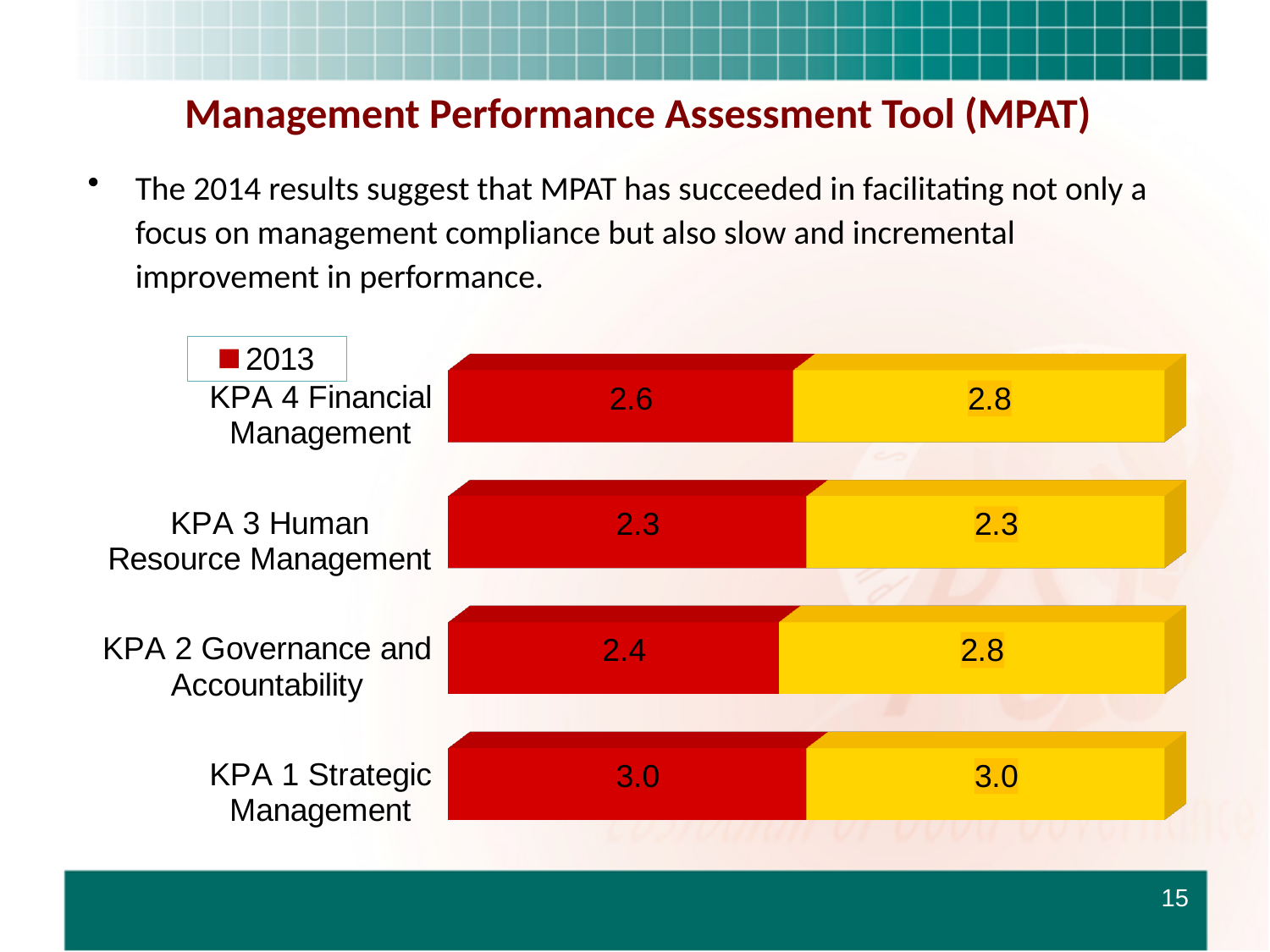
What is the 2013 value for KPA 4 Financial Management? 2.6 For KPA 4 Financial Management, what is the difference between the yellow segment value and the 2013 value? 0.2 What value is shown in the yellow segment for KPA 2 Governance and Accountability? 2.8 For KPA 2 Governance and Accountability, how much larger is the yellow segment value than the 2013 value? 0.4 What is the 2013 value for KPA 1 Strategic Management? 3.0 How many KPA categories are shown in the chart? 4 What colour represents the 2013 series in the chart? Red Which has the larger 2013 value, KPA 4 Financial Management or KPA 2 Governance and Accountability? KPA 4 Financial Management What kind of chart is shown on the slide? Bar chart What value is shown in the yellow segment for KPA 3 Human Resource Management? 2.3 Which KPA has the lowest 2013 value? KPA 3 Human Resource Management Which KPA has the highest 2013 value? KPA 1 Strategic Management